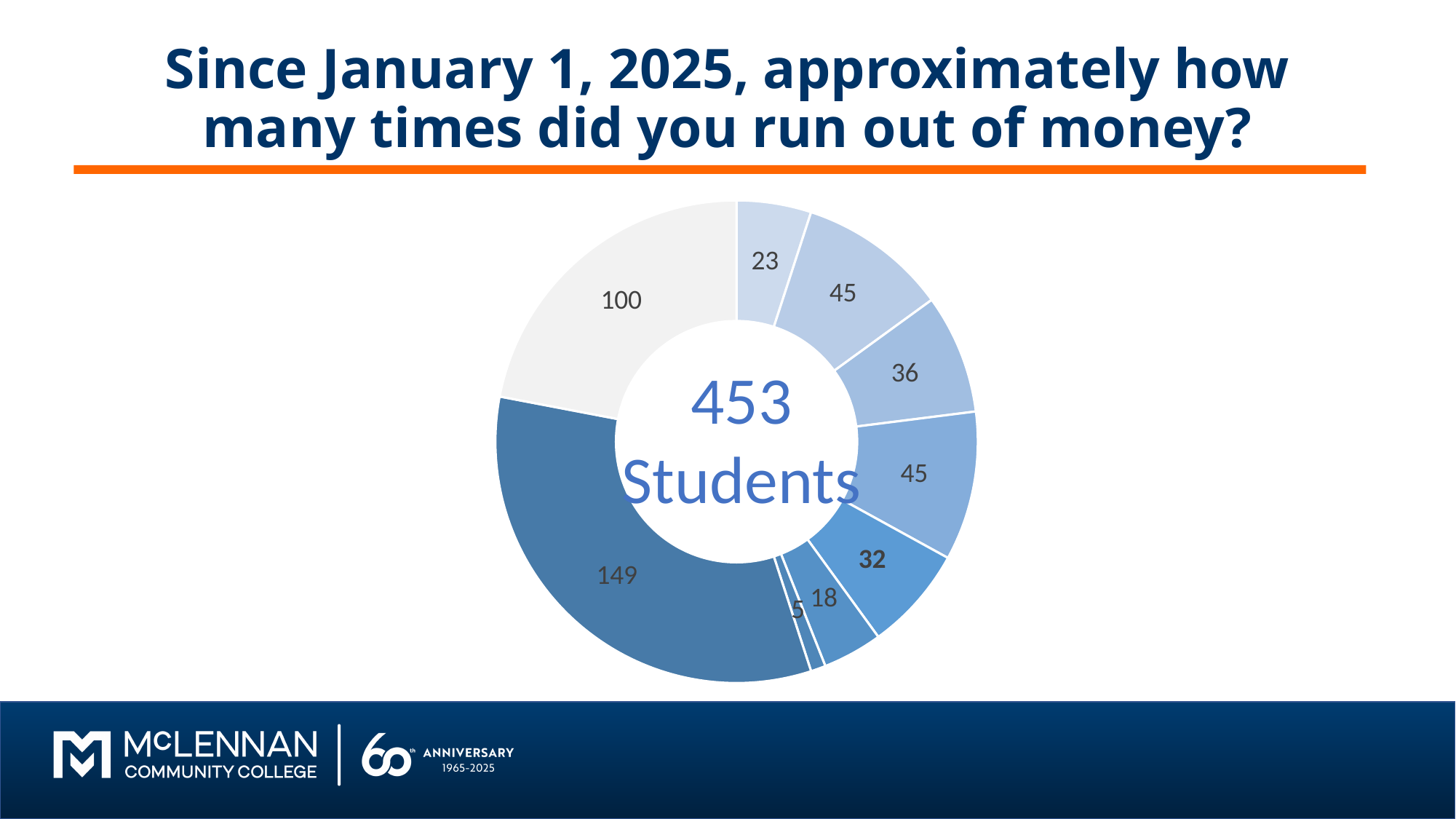
How many slices does the donut chart have? 9 What is the title of the slide containing the donut chart? Since January 1, 2025, approximately how many times did you run out of money? What total number of students is shown in the centre of the donut chart? 453 Students Is the slice labelled 100 larger or smaller than the slice labelled 149? smaller What is the difference between the largest slice (149) and the second-largest slice (100)? 49 What is the value of the largest slice in the donut chart? 149 How many slices in the donut chart are labelled 45? 2 What is the value of the smallest slice in the donut chart? 5 What is the difference between the slices labelled 32 and 18? 14 What colour is the slice labelled 100 in the donut chart? light grey What type of chart is shown on the slide? donut (pie) chart What is the difference between the slices labelled 45 and 36? 9